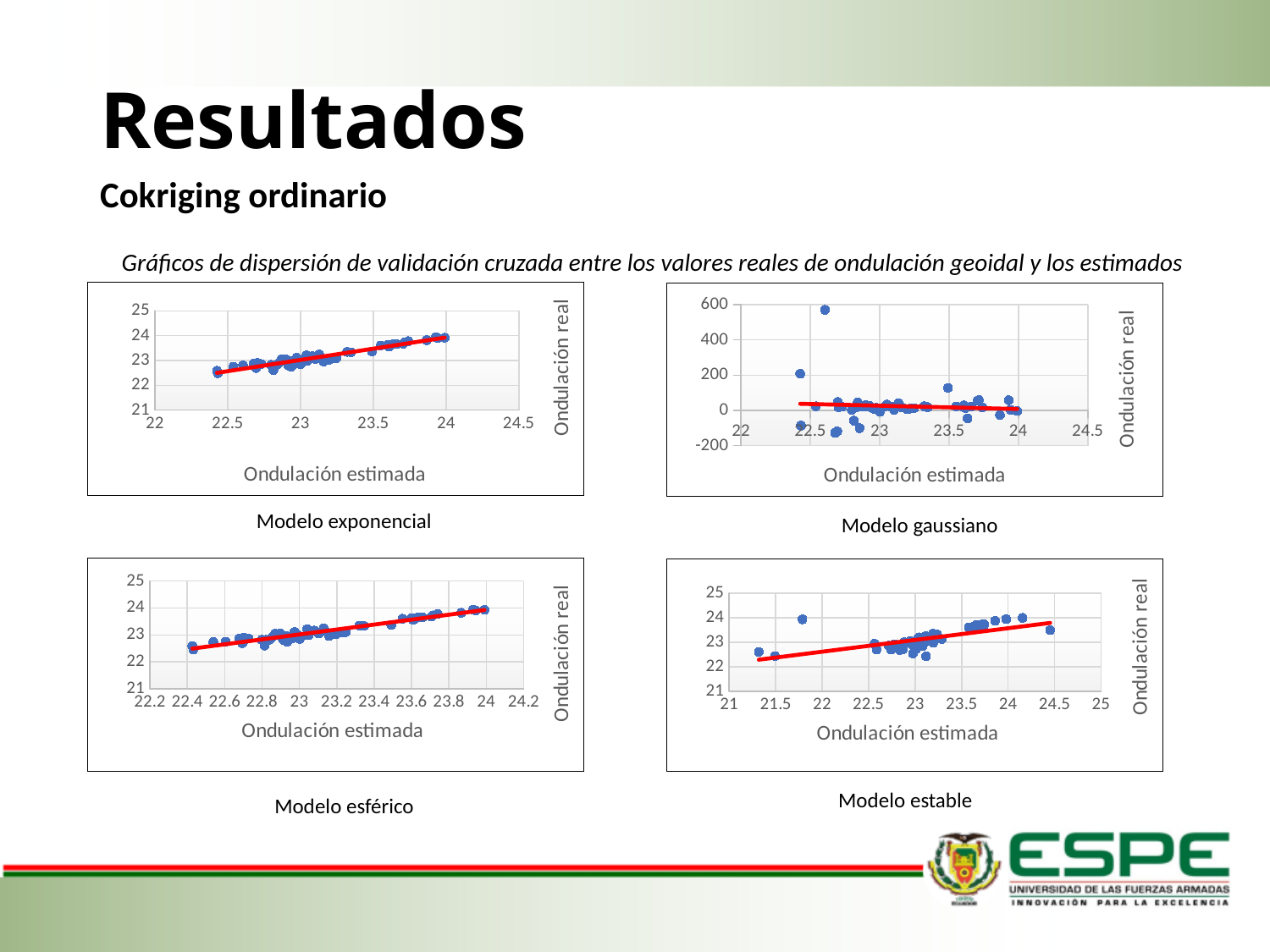
In the 'Modelo gaussiano' chart, does the red trend line rise or fall along the x axis? fall In the 'Modelo estable' chart, is the isolated point near 21.8 on the x axis greater or less than 23 on the y axis? greater What kind of chart is the 'Modelo estable' chart? scatter chart What kind of chart is the 'Modelo exponencial' chart? scatter chart What is the y-axis label of the 'Modelo esférico' chart? Ondulación real How many scatter charts are shown on the slide? 4 In the 'Modelo exponencial' chart, are all the plotted points greater or less than 22 on the y axis? greater In the 'Modelo exponencial' chart, do the plotted values rise or fall along the x axis? rise In the 'Modelo esférico' chart, do the plotted values rise or fall along the x axis? rise What is the x-axis label of the 'Modelo gaussiano' chart? Ondulación estimada In the 'Modelo gaussiano' chart, is the highest plotted point greater or less than 400? greater